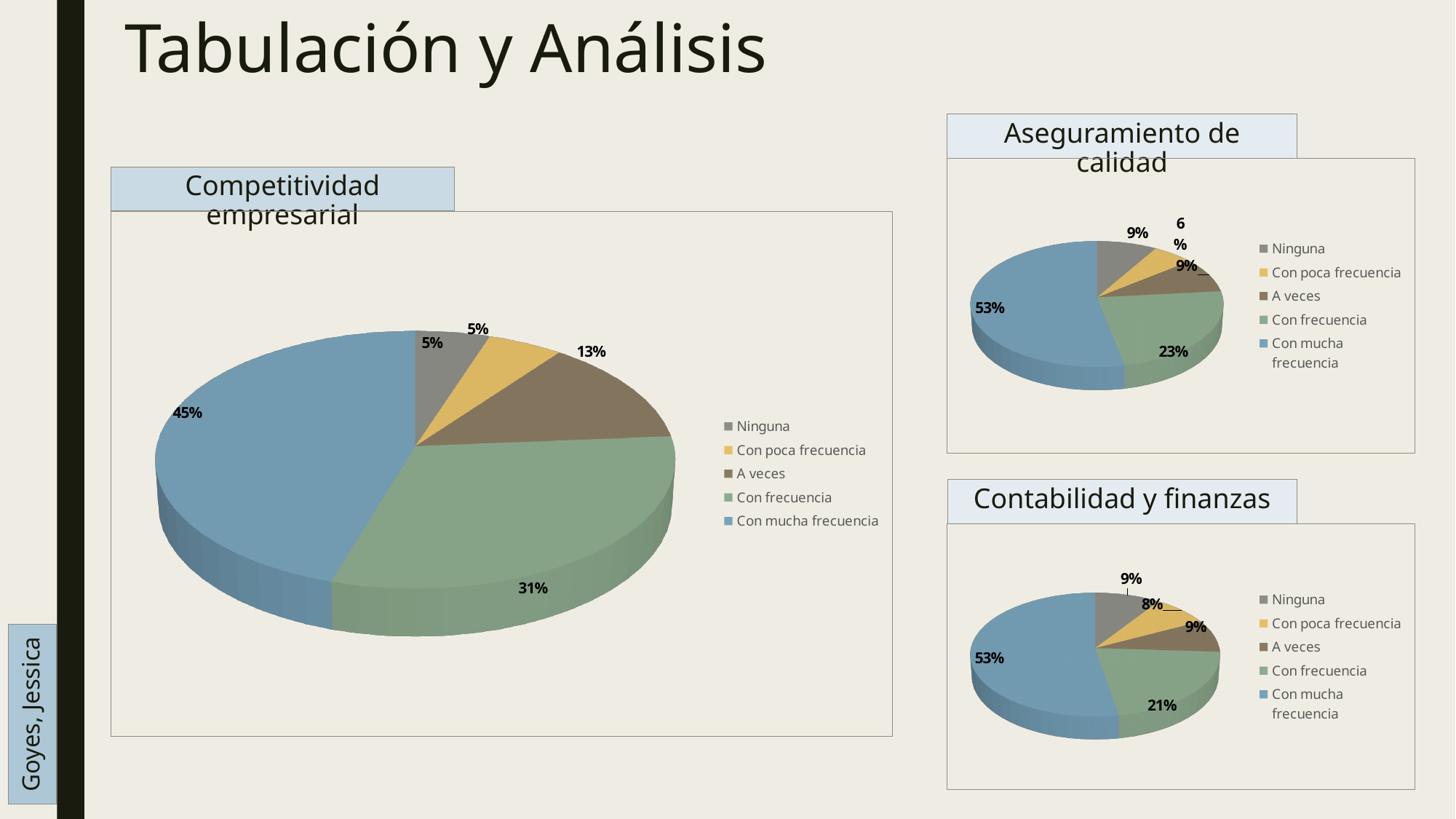
In the 'Competitividad empresarial' chart, what percentage is shown for 'Con mucha frecuencia'? 45% In the 'Competitividad empresarial' chart, what percentage is shown for 'A veces'? 13% In the 'Contabilidad y finanzas' chart, which is larger, 'Con frecuencia' or 'A veces'? Con frecuencia In the 'Competitividad empresarial' chart, what is the difference between 'Con mucha frecuencia' and 'Con frecuencia'? 14% In the 'Contabilidad y finanzas' chart, what percentage is shown for 'Con frecuencia'? 21% In the 'Competitividad empresarial' chart, which category has the largest slice? Con mucha frecuencia In the 'Contabilidad y finanzas' chart, what percentage is shown for 'Con poca frecuencia'? 8% How many categories does the legend of the 'Competitividad empresarial' chart list? 5 In the 'Aseguramiento de calidad' chart, which category has the smallest slice? Con poca frecuencia In the 'Aseguramiento de calidad' chart, what percentage is shown for 'Con mucha frecuencia'? 53% What type of chart is used for 'Contabilidad y finanzas'? Pie chart In the 'Aseguramiento de calidad' chart, what percentage is shown for 'Con frecuencia'? 23%